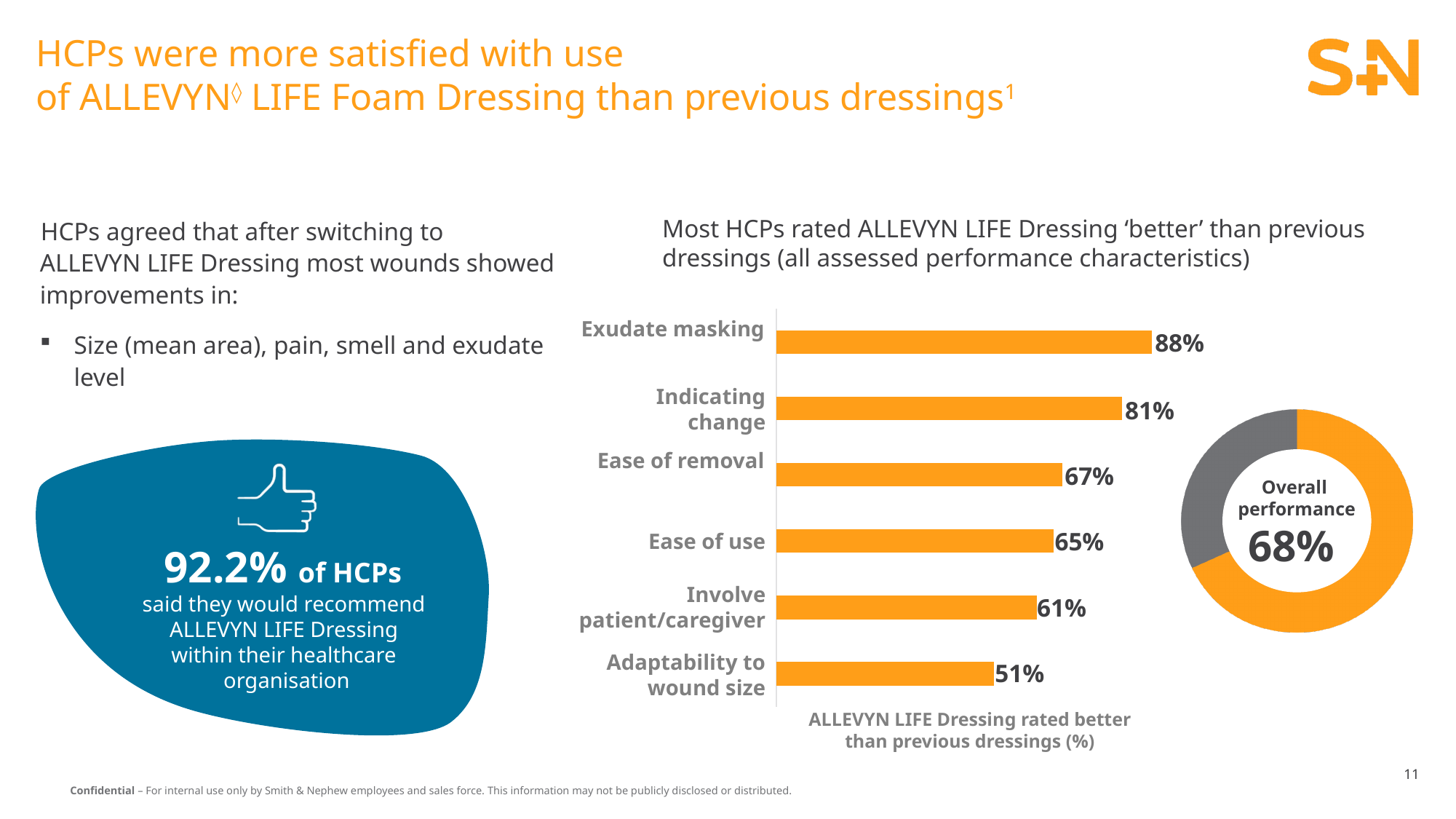
How many performance characteristics are shown in the bar chart? 6 In the bar chart, which performance characteristic has the lowest percentage? Adaptability to wound size In the bar chart, what percentage of HCPs rated ALLEVYN LIFE Dressing better than previous dressings for Exudate masking? 88% In the bar chart, which is larger: the value for Ease of removal or the value for Involve patient/caregiver? Ease of removal In the bar chart, what is the value for Involve patient/caregiver? 61% In the bar chart, what is the value for Ease of removal? 67% In the bar chart, which performance characteristic has the highest percentage? Exudate masking What kind of chart is used to show the percentages for the performance characteristics? Bar chart In the donut chart on the right, what is the Overall performance value? 68% In the bar chart, what is the difference between the values for Exudate masking and Adaptability to wound size? 37% What is the axis label shown beneath the bar chart? ALLEVYN LIFE Dressing rated better than previous dressings (%) In the bar chart, what is the difference between the values for Indicating change and Ease of use? 16%